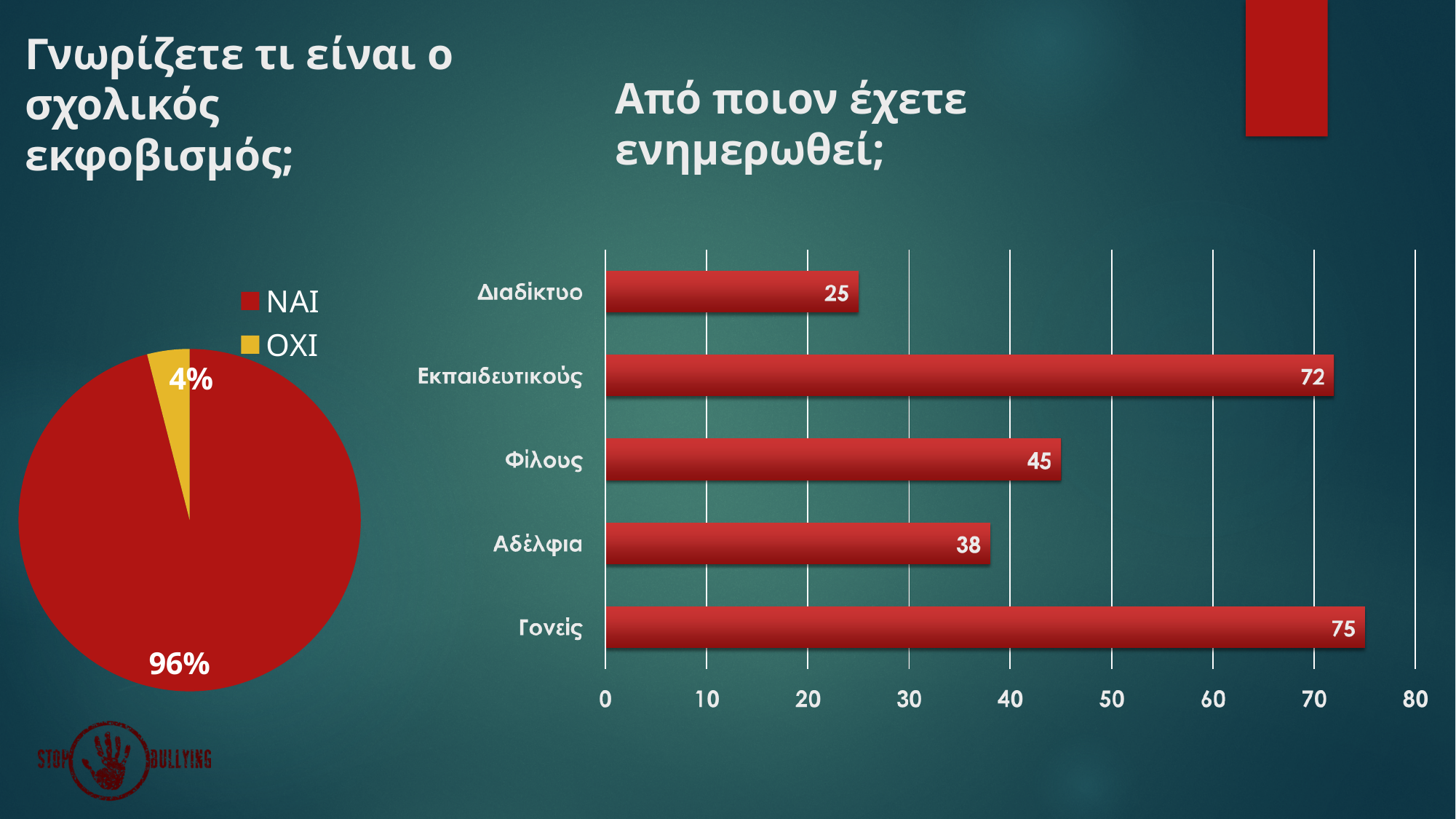
What kind of chart is the chart on the right? Bar chart In the bar chart on the right, which is larger, the value for Φίλους or the value for Αδέλφια? Φίλους In the bar chart on the right, what is the value for Γονείς? 75 In the bar chart on the right, which category has the highest value? Γονείς In the pie chart on the left, what share is labelled for ΟΧΙ? 4% In the pie chart on the left, what share is labelled for ΝΑΙ? 96% In the pie chart on the left, which colour represents ΟΧΙ? Yellow In the pie chart on the left, how many entries does the legend list? 2 In the bar chart on the right, what is the difference between the values for Εκπαιδευτικούς and Αδέλφια? 34 In the bar chart on the right, what is the value for Διαδίκτυο? 25 In the bar chart on the right, which category has the lowest value? Διαδίκτυο In the bar chart on the right, how many categories are shown? 5